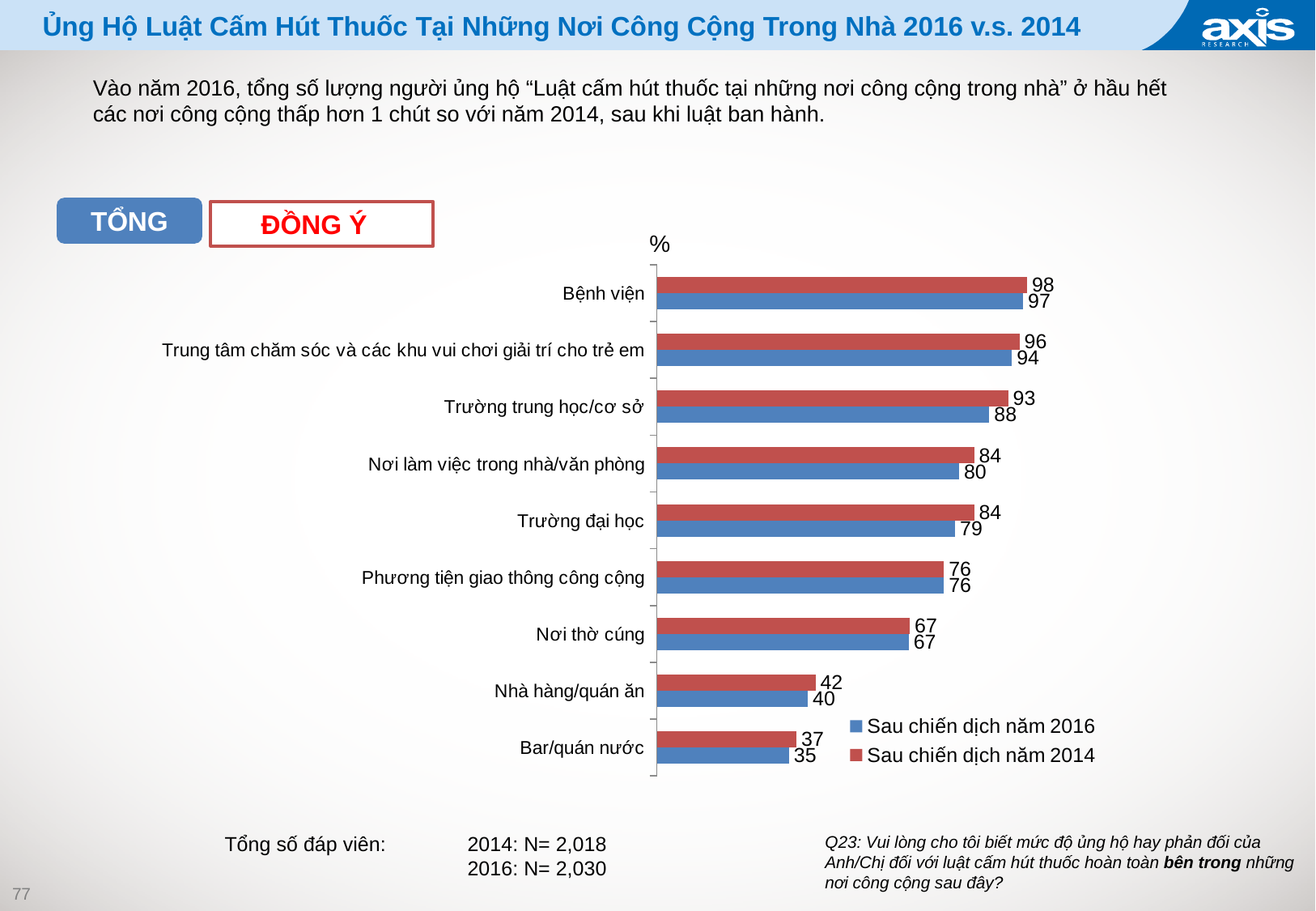
What is the value for Trường trung học/cơ sở in the series Sau chiến dịch năm 2014? 93 Which is larger for Nơi làm việc trong nhà/văn phòng: the Sau chiến dịch năm 2014 value or the Sau chiến dịch năm 2016 value? Sau chiến dịch năm 2014 How many categories are shown on the chart? 9 How many series does the legend list? 2 What is the difference between the 2014 and 2016 values for Trường đại học? 5 What is the value for Bệnh viện in the series Sau chiến dịch năm 2016? 97 Which colour represents the series Sau chiến dịch năm 2014? Red Which category has the highest value in the series Sau chiến dịch năm 2014? Bệnh viện Which category has the lowest value in the series Sau chiến dịch năm 2016? Bar/quán nước What kind of chart is shown on the slide? Bar chart What is the difference between the 2014 and 2016 values for Trường trung học/cơ sở? 5 What is the value for Nhà hàng/quán ăn in the series Sau chiến dịch năm 2016? 40